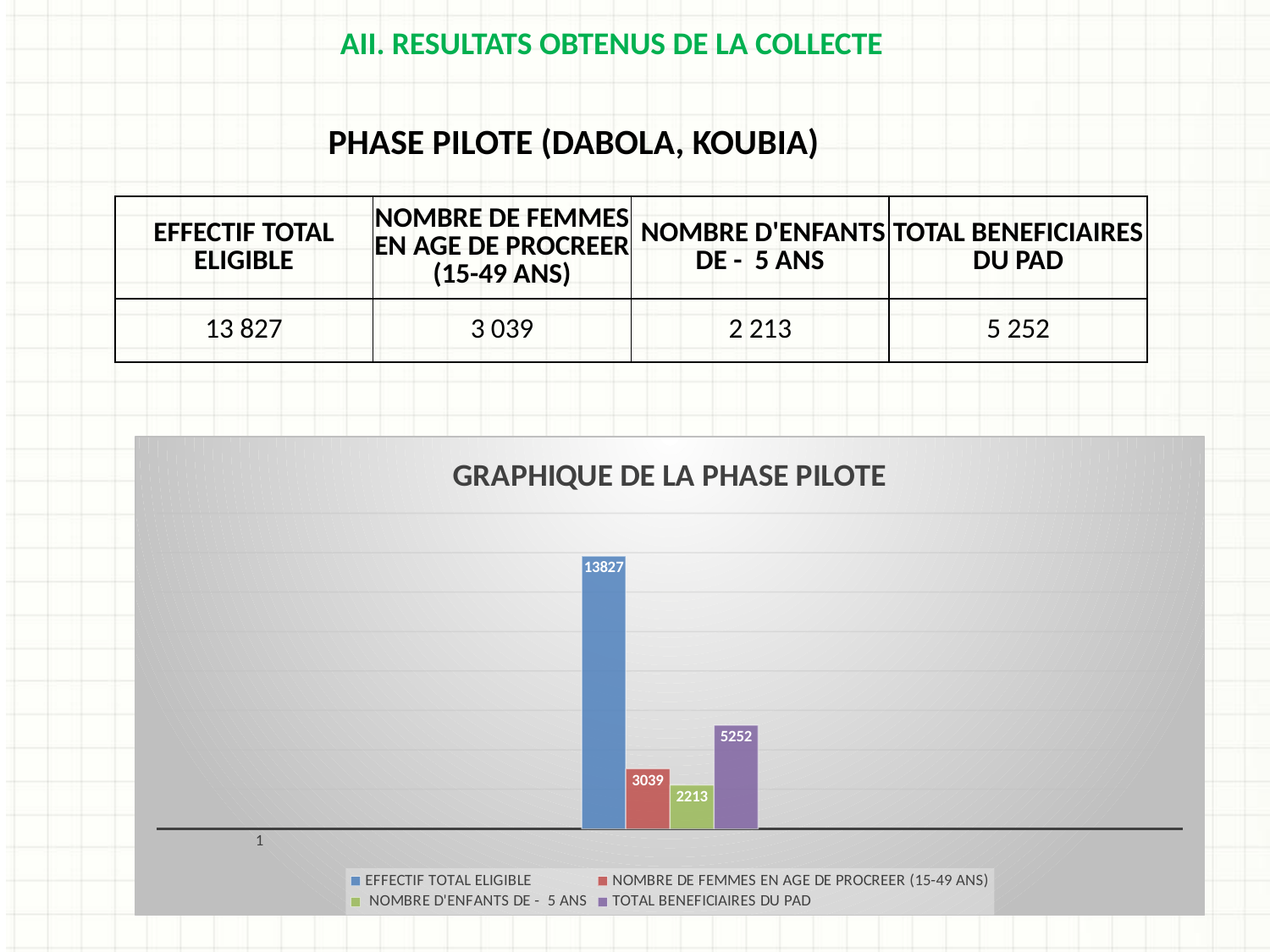
Which series has the lowest bar in the chart? NOMBRE D'ENFANTS DE - 5 ANS What is the value of the NOMBRE D'ENFANTS DE - 5 ANS bar in the chart? 2213 What is the difference between the EFFECTIF TOTAL ELIGIBLE bar and the TOTAL BENEFICIAIRES DU PAD bar? 8575 Which is larger in the chart: TOTAL BENEFICIAIRES DU PAD or NOMBRE DE FEMMES EN AGE DE PROCREER (15-49 ANS)? TOTAL BENEFICIAIRES DU PAD Which series has the highest bar in the chart? EFFECTIF TOTAL ELIGIBLE What is the value of the NOMBRE DE FEMMES EN AGE DE PROCREER (15-49 ANS) bar in the chart? 3039 What kind of chart is shown on the slide? Bar chart What is the difference between the NOMBRE DE FEMMES EN AGE DE PROCREER (15-49 ANS) bar and the NOMBRE D'ENFANTS DE - 5 ANS bar? 826 What is the title of the chart? GRAPHIQUE DE LA PHASE PILOTE How many series does the chart legend list? 4 What is the value of the EFFECTIF TOTAL ELIGIBLE bar in the chart? 13827 What is the value of the TOTAL BENEFICIAIRES DU PAD bar in the chart? 5252